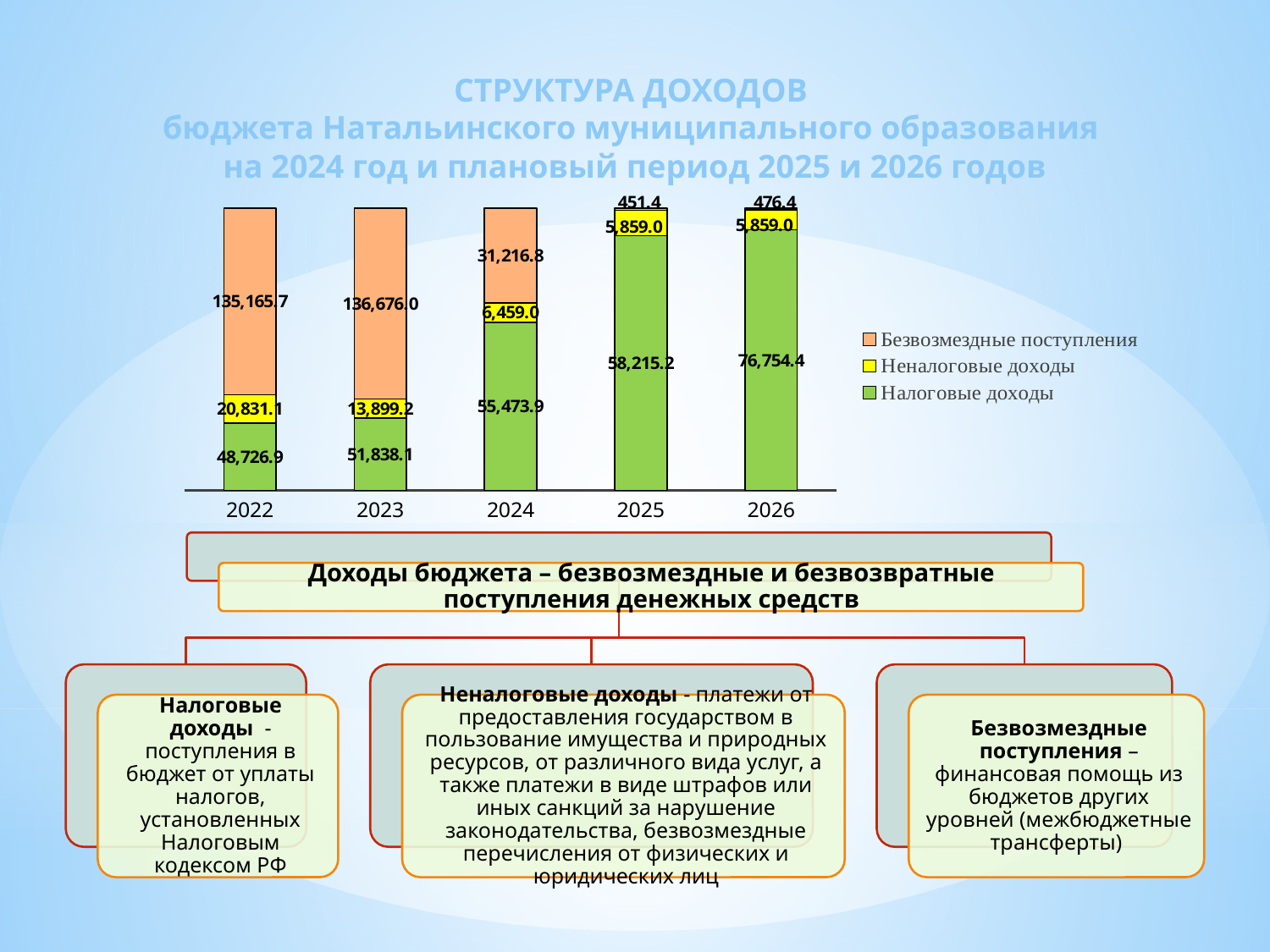
Which is larger: Безвозмездные поступления in 2022 or in 2024? 2022 In which year is Неналоговые доходы the highest? 2022 What is the value of Неналоговые доходы for 2024? 6,459.0 What is the difference between Налоговые доходы in 2026 and in 2025? 18,539.2 What is the value of Налоговые доходы for 2022? 48,726.9 In which year is Безвозмездные поступления the lowest? 2025 In which year is Налоговые доходы the highest? 2026 How many series does the legend list? 3 What is the value of Безвозмездные поступления for 2026? 476.4 How many years are shown on the x axis? 5 Does Налоговые доходы rise or fall from 2022 to 2026? rise What is the value of Безвозмездные поступления for 2023? 136,676.0